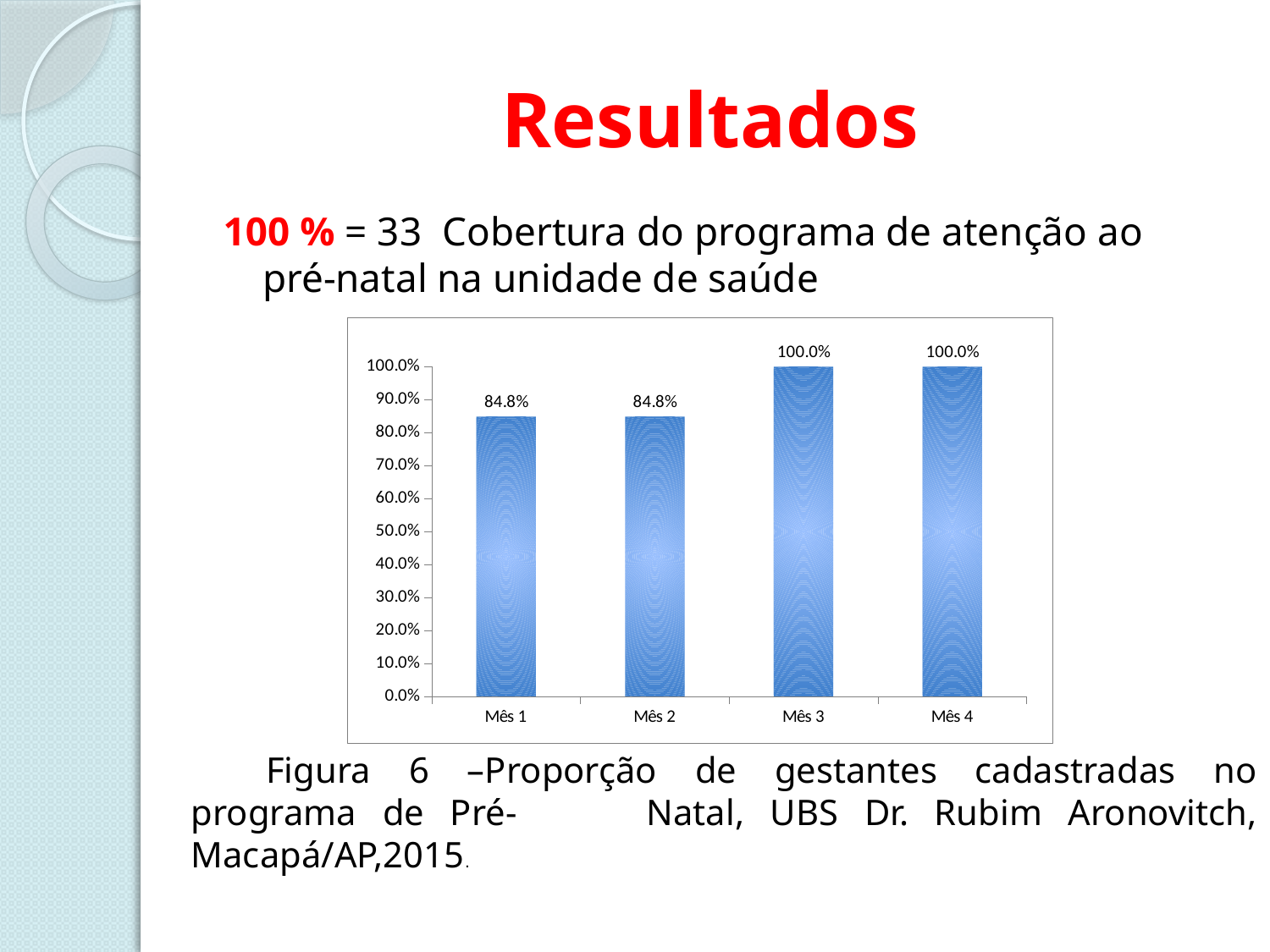
How many categories are shown on the x axis of the chart? 4 What kind of chart is shown on the slide? bar chart Which is larger, the value for Mês 2 or the value for Mês 4? Mês 4 What is the value for Mês 1? 84.8% What is the value for Mês 3? 100.0% What is the highest value shown on the y axis of the chart? 100.0% What is the value for Mês 4? 100.0% Is the value for Mês 1 greater or less than 90.0%? less Do the values rise or fall from Mês 1 to Mês 4? rise What colour are the bars in the chart? blue What is the difference between the values for Mês 3 and Mês 1? 15.2% What is the value for Mês 2? 84.8%